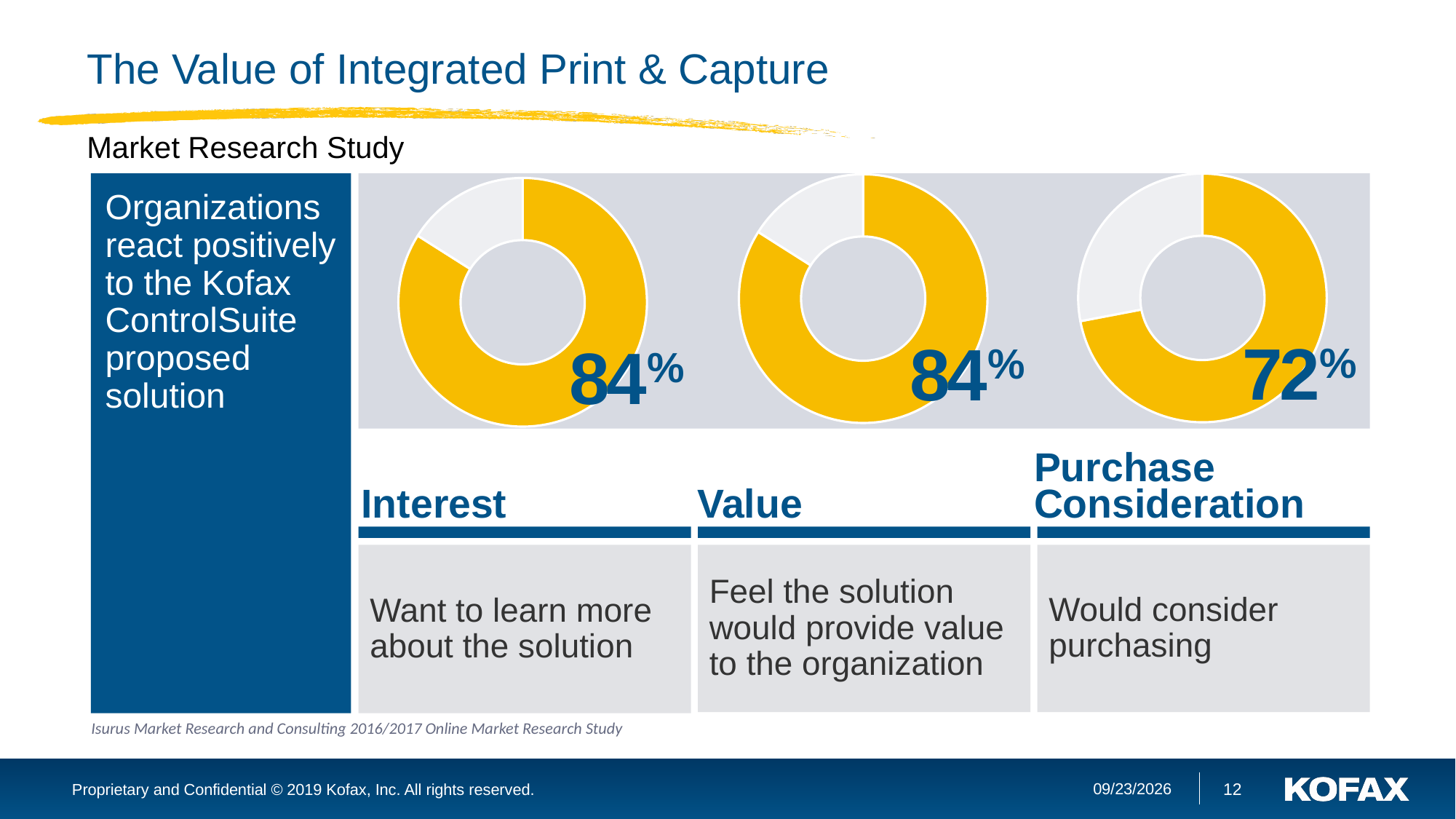
What percentage is shown on the Purchase Consideration donut chart? 72% Do the Interest and Value donut charts show the same percentage? Yes Is the Value percentage larger or smaller than the Purchase Consideration percentage? larger What percentage is shown on the Interest donut chart? 84% What colour is the filled portion of each donut chart? yellow What kind of chart is used to show the Interest, Value and Purchase Consideration percentages? donut chart How many donut charts are shown on the slide? 3 What is the label of the rightmost donut chart? Purchase Consideration Is the Purchase Consideration percentage greater or less than 80%? less Which of the three donut charts shows the lowest percentage? Purchase Consideration What percentage is shown on the Value donut chart? 84% What is the difference between the Interest percentage and the Purchase Consideration percentage? 12%